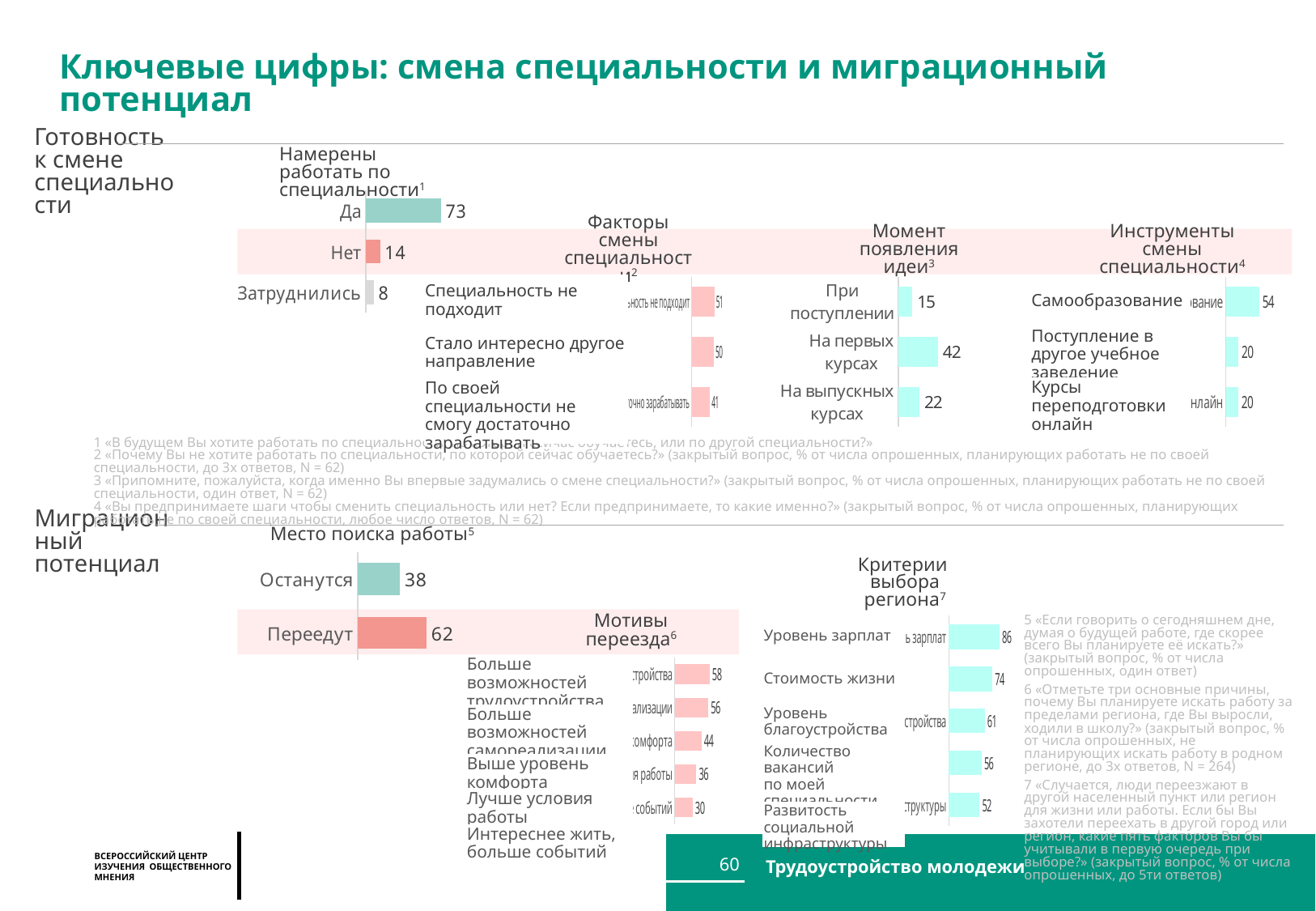
What type of chart is the 'Критерии выбора региона' chart? Bar chart In the 'Место поиска работы' chart, what is the value for 'Переедут'? 62 In the 'Место поиска работы' chart, which is larger: 'Останутся' or 'Переедут'? Переедут In the 'Намерены работать по специальности' chart, which category has the lowest value? Затруднились In the 'Инструменты смены специальности' chart, what is the value for 'Самообразование'? 54 How many categories are shown in the 'Мотивы переезда' chart? 5 In the 'Критерии выбора региона' chart, what is the value for 'Уровень зарплат'? 86 In the 'Факторы смены специальности' chart, what is the value for 'Специальность не подходит'? 51 In the 'Намерены работать по специальности' chart, what is the value for 'Да'? 73 In the 'Момент появления идеи' chart, which category has the highest value? На первых курсах In the 'Момент появления идеи' chart, what is the value for 'На выпускных курсах'? 22 In the 'Намерены работать по специальности' chart, what is the difference between 'Да' and 'Нет'? 59